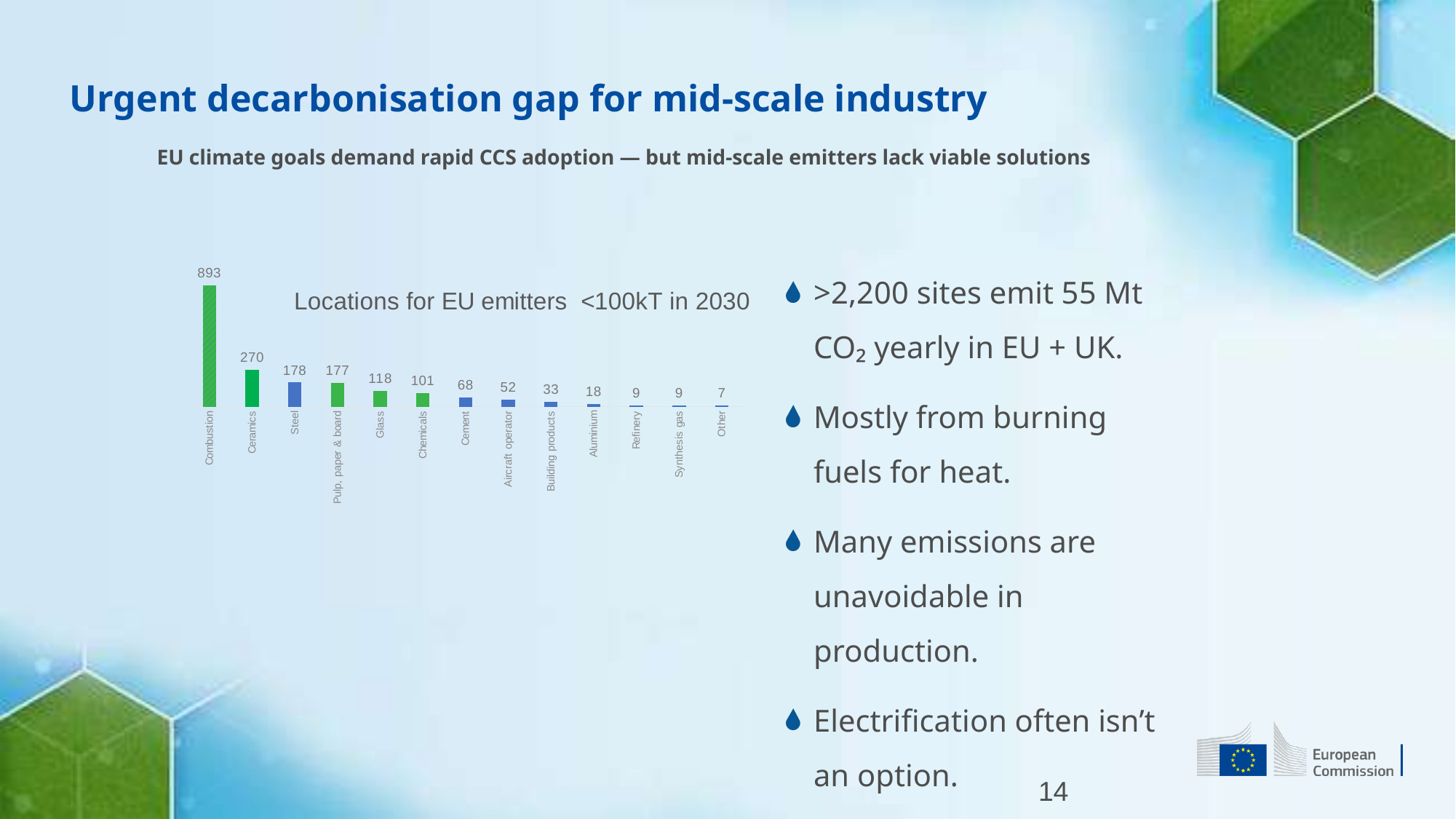
What is the value for Ceramics? 270 What is the value for Combustion? 893 What is the value for Aircraft operator? 52 What kind of chart is shown on the slide? Bar chart Which category has the lowest value? Other Which category has the highest value? Combustion What is the value for Pulp, paper & board? 177 Which is larger, the value for Glass or the value for Chemicals? Glass What is the difference between the values for Combustion and Ceramics? 623 Do the values rise or fall from left to right along the x axis? Fall How many categories are shown on the x axis? 13 What is the title of the chart? Locations for EU emitters <100kT in 2030